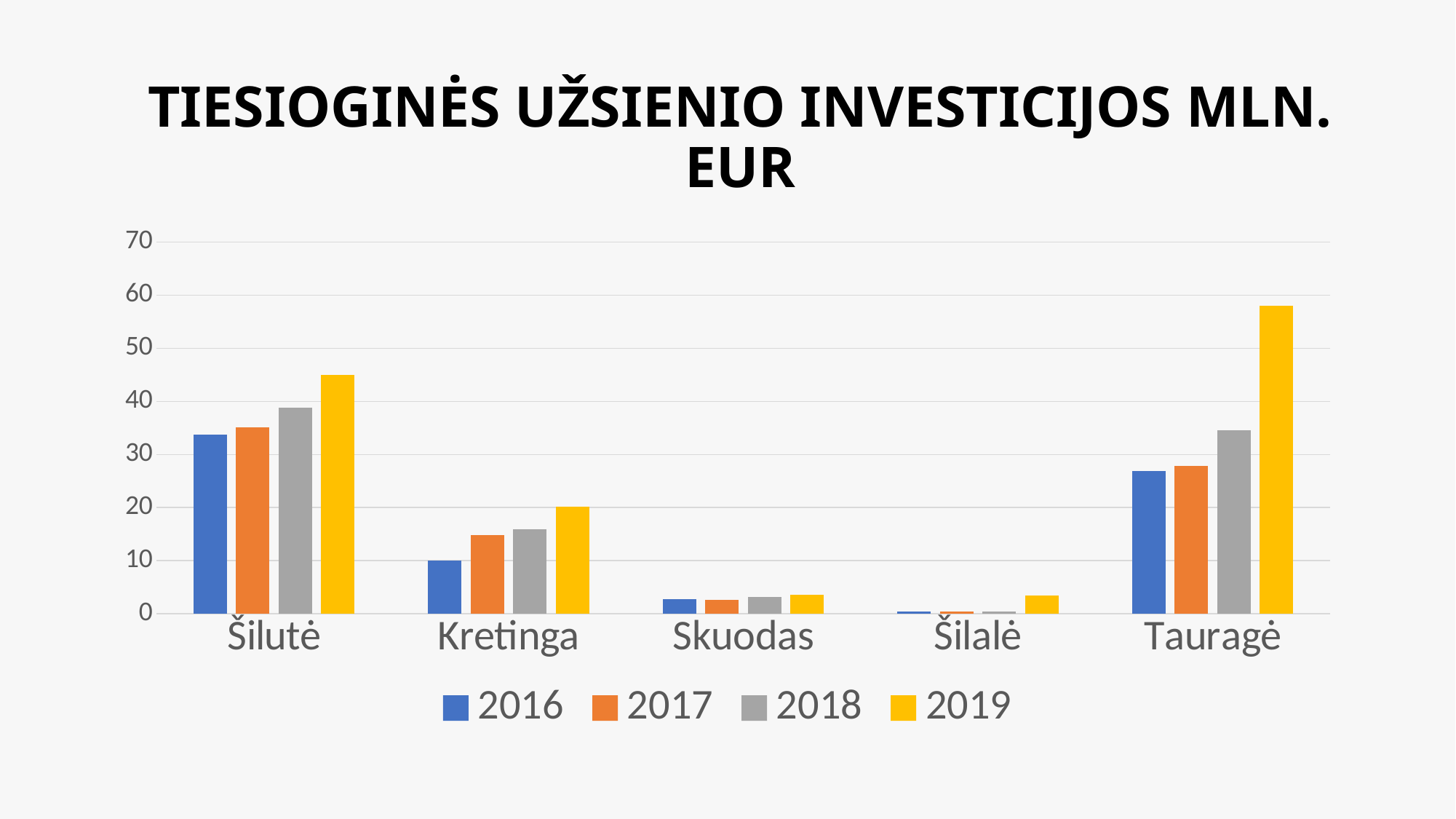
How many series does the legend list? 4 Which category has the lowest value for 2016? Šilalė What is the title of the chart? TIESIOGINĖS UŽSIENIO INVESTICIJOS MLN. EUR Is the value for Šilutė in 2019 greater or less than 40? greater Which year is represented by the yellow bars in the legend? 2019 Which is larger, the 2016 value for Šilutė or the 2016 value for Tauragė? Šilutė Is the value for Kretinga in 2019 greater or less than 30? less What kind of chart is shown on the slide? bar chart How many categories are shown on the x axis? 5 Do the values for Tauragė rise or fall from 2016 to 2019? rise Which category has the highest value for 2019? Tauragė Is the value for Tauragė in 2019 greater or less than 50? greater